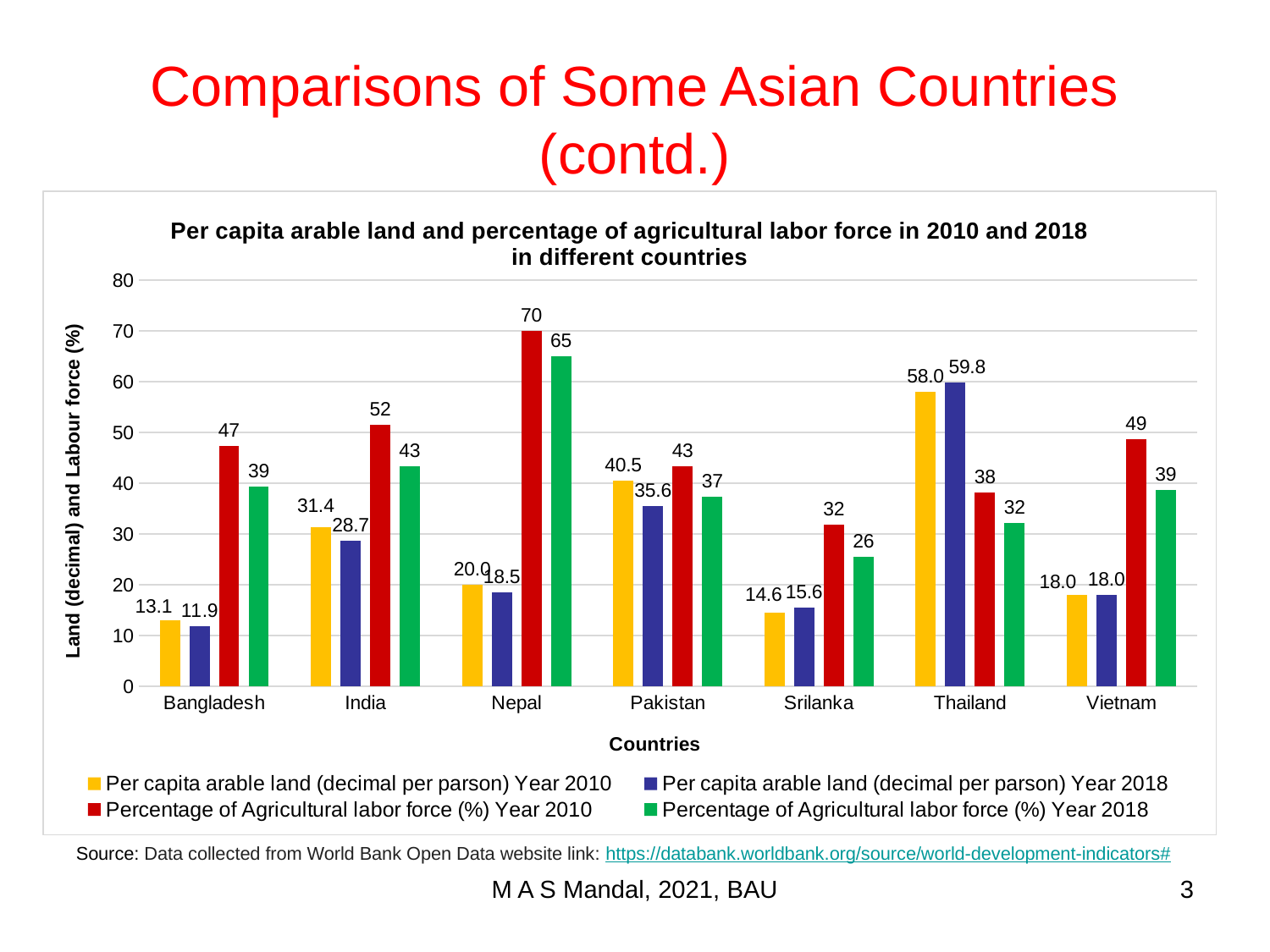
How many series does the legend list? 4 What is the Per capita arable land (decimal per parson) Year 2018 value for Thailand? 59.8 What is the difference between Thailand's Per capita arable land in 2018 and in 2010? 1.8 What is the Percentage of Agricultural labor force (%) Year 2010 for Nepal? 70 What type of chart is shown on the slide? Bar chart Which country has the lowest Per capita arable land (decimal per parson) Year 2018? Bangladesh Which country has the highest Percentage of Agricultural labor force (%) Year 2018? Nepal How many countries are shown on the x axis? 7 What is the Percentage of Agricultural labor force (%) Year 2018 for Srilanka? 26 By how much did Nepal's Percentage of Agricultural labor force (%) fall from 2010 to 2018? 5 Which country has the highest Per capita arable land (decimal per parson) Year 2010? Thailand Which is larger: Pakistan's or India's Per capita arable land (decimal per parson) Year 2010? Pakistan